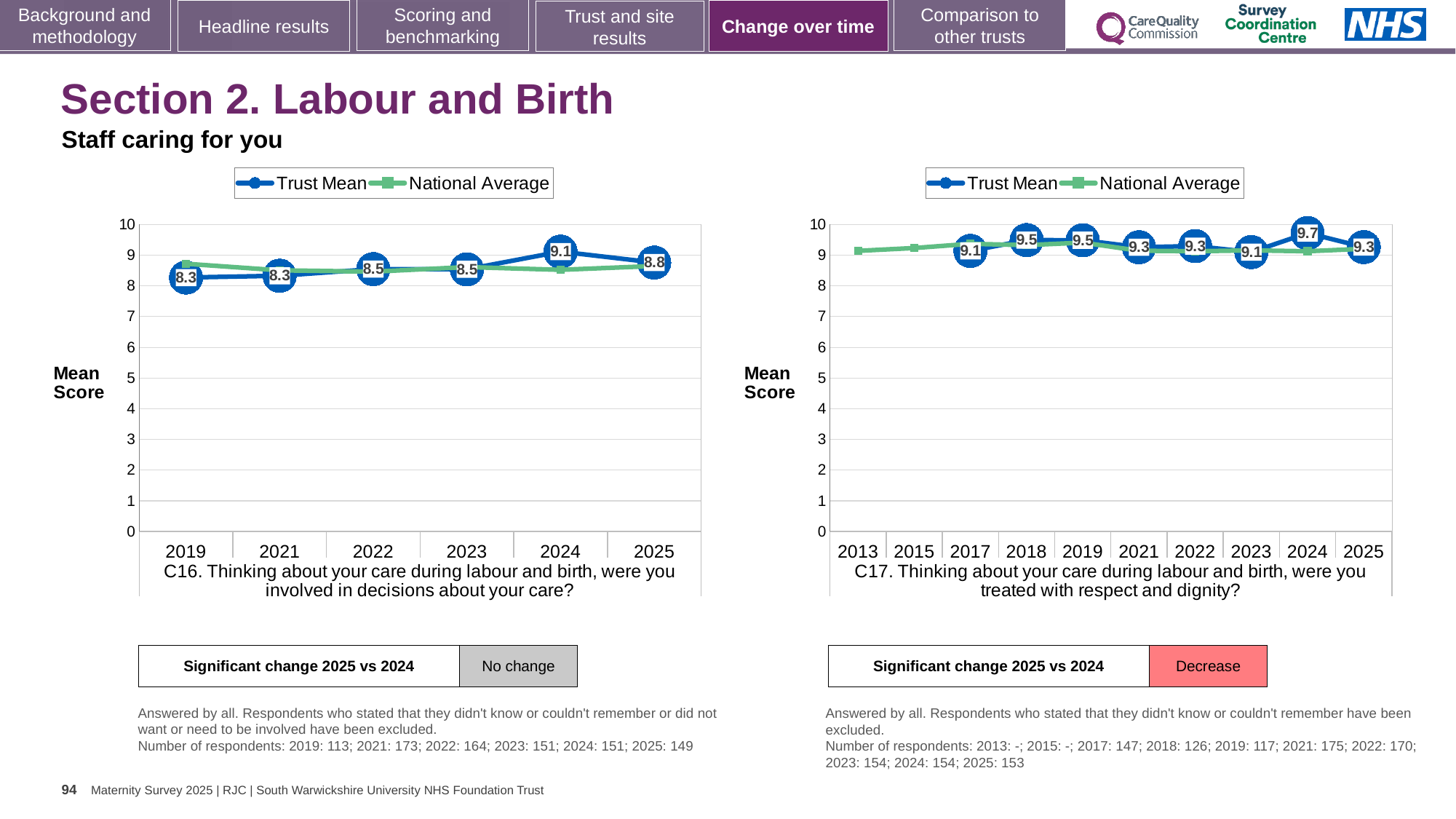
In the C17 chart on the right, how many series does the legend list? 2 In the C16 chart on the left, which year has the highest Trust Mean score? 2024 In the C17 chart on the right, what is the Trust Mean score for 2017? 9.1 In the C16 chart on the left, what is the Trust Mean score for 2025? 8.8 In the C16 chart on the left, how many years are shown on the x axis? 6 In the C17 chart on the right, which year has the highest Trust Mean score? 2024 What type of chart is the C16 chart on the left? line chart In the C16 chart on the left, is the Trust Mean score for 2019 greater or less than 9? less In the C16 chart on the left, what is the difference between the Trust Mean scores for 2024 and 2025? 0.3 In the C16 chart on the left, what is the Trust Mean score for 2024? 9.1 In the C17 chart on the right, is the Trust Mean score for 2018 larger or smaller than the score for 2023? larger In the C17 chart on the right, what is the Trust Mean score for 2024? 9.7